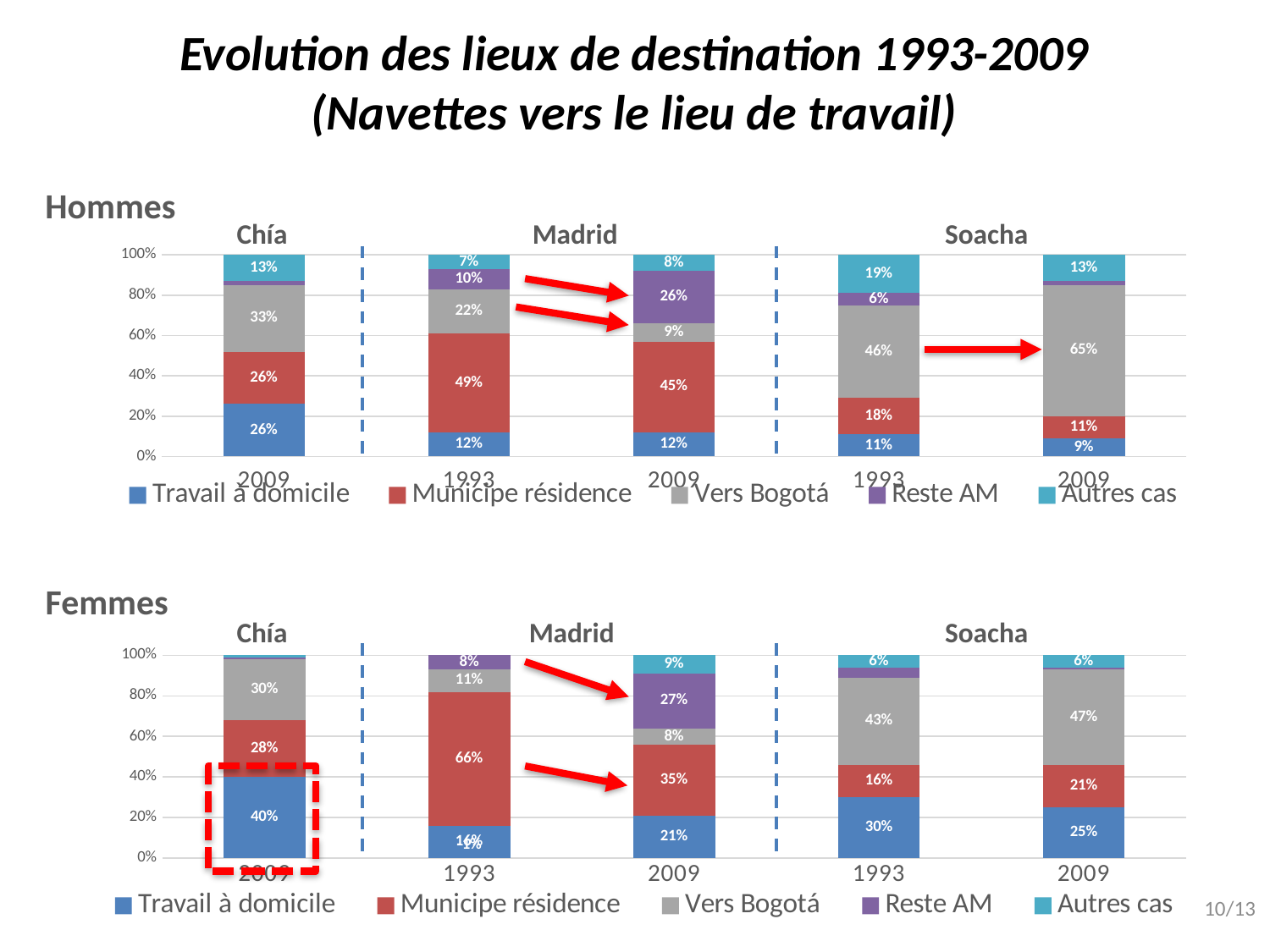
In the Femmes chart, what is the Vers Bogotá share for Soacha in 2009? 47% In the Hommes chart, by how many percentage points did the Vers Bogotá share for Soacha change between 1993 and 2009? 19 percentage points How many series does the legend of the Femmes chart list? 5 In the Femmes chart, what is the Municipe résidence share for Madrid in 1993? 66% In the Hommes chart, what is the Reste AM share for Madrid in 2009? 26% In the Hommes chart, what is the Municipe résidence share for Madrid in 1993? 49% In the Hommes chart, which bar has the largest Vers Bogotá share? Soacha 2009 What kind of chart is the Hommes chart? Stacked bar chart In the Hommes chart, what is the Vers Bogotá share for Soacha in 2009? 65% In the Femmes chart, what is the Travail à domicile share for Chía in 2009? 40% In the Femmes chart, which is larger for Madrid in 2009: the Municipe résidence share or the Reste AM share? Municipe résidence How many bars are plotted in the Femmes chart? 5